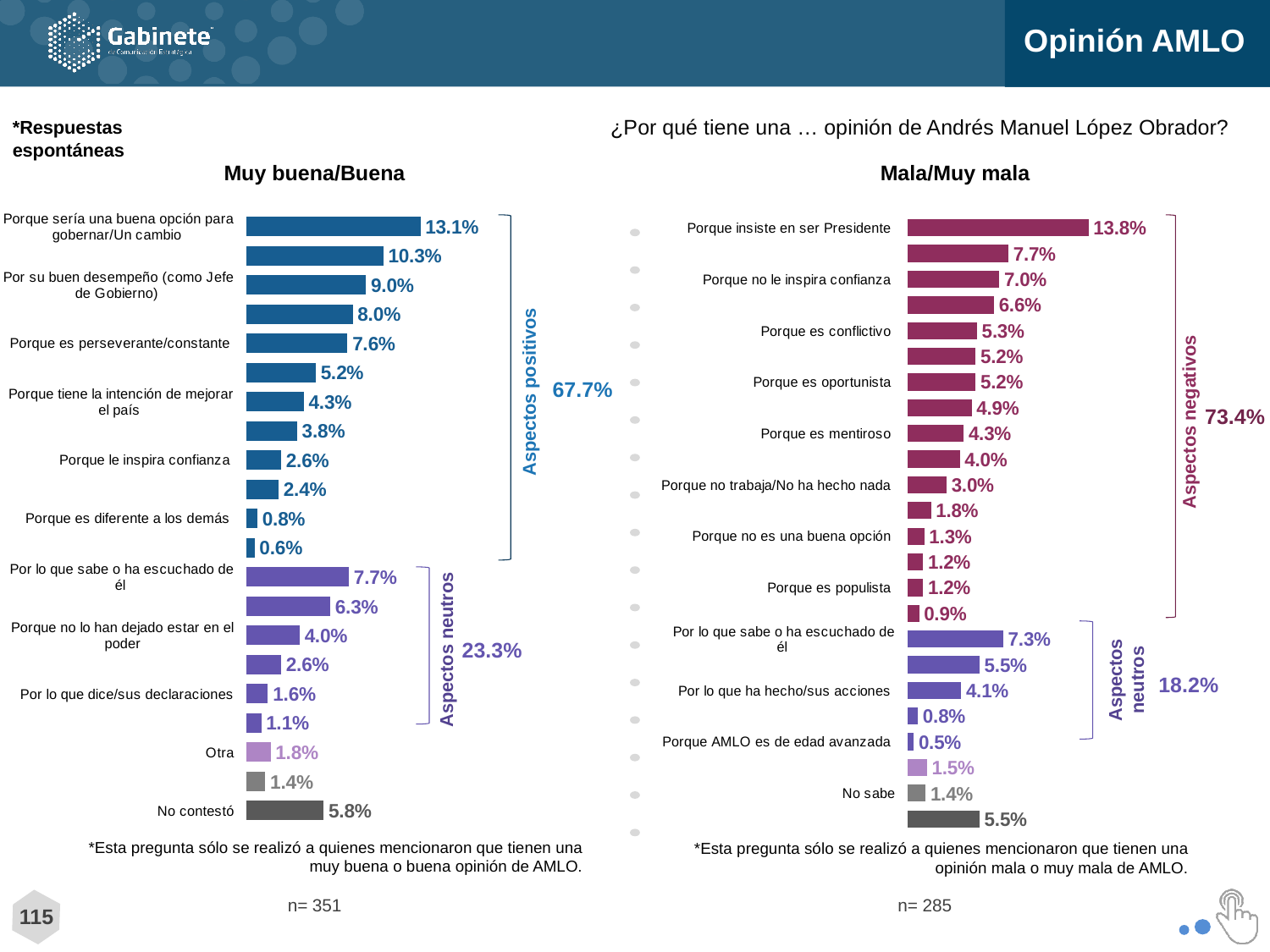
In the 'Mala/Muy mala' chart, what is the value for 'Porque insiste en ser Presidente'? 13.8% In the 'Muy buena/Buena' chart, what is the value for 'No contestó'? 5.8% In the 'Mala/Muy mala' chart, which is larger: 'Porque no le inspira confianza' or 'Porque es conflictivo'? Porque no le inspira confianza In the 'Mala/Muy mala' chart, which labelled category has the highest value? Porque insiste en ser Presidente In the 'Muy buena/Buena' chart, what is the difference between 'Porque sería una buena opción para gobernar/Un cambio' and 'Por su buen desempeño (como Jefe de Gobierno)'? 4.1% What type of chart is used on this slide? Bar chart In the 'Muy buena/Buena' chart, what is the value for 'Porque sería una buena opción para gobernar/Un cambio'? 13.1% In the 'Muy buena/Buena' chart, what is the value for 'Por lo que sabe o ha escuchado de él'? 7.7% In the 'Muy buena/Buena' chart, what is the total share for 'Aspectos neutros'? 23.3% In the 'Mala/Muy mala' chart, what is the value for 'Porque es mentiroso'? 4.3% In the 'Mala/Muy mala' chart, what is the total share for 'Aspectos negativos'? 73.4% In the 'Muy buena/Buena' chart, which labelled category has the lowest value? Porque es diferente a los demás